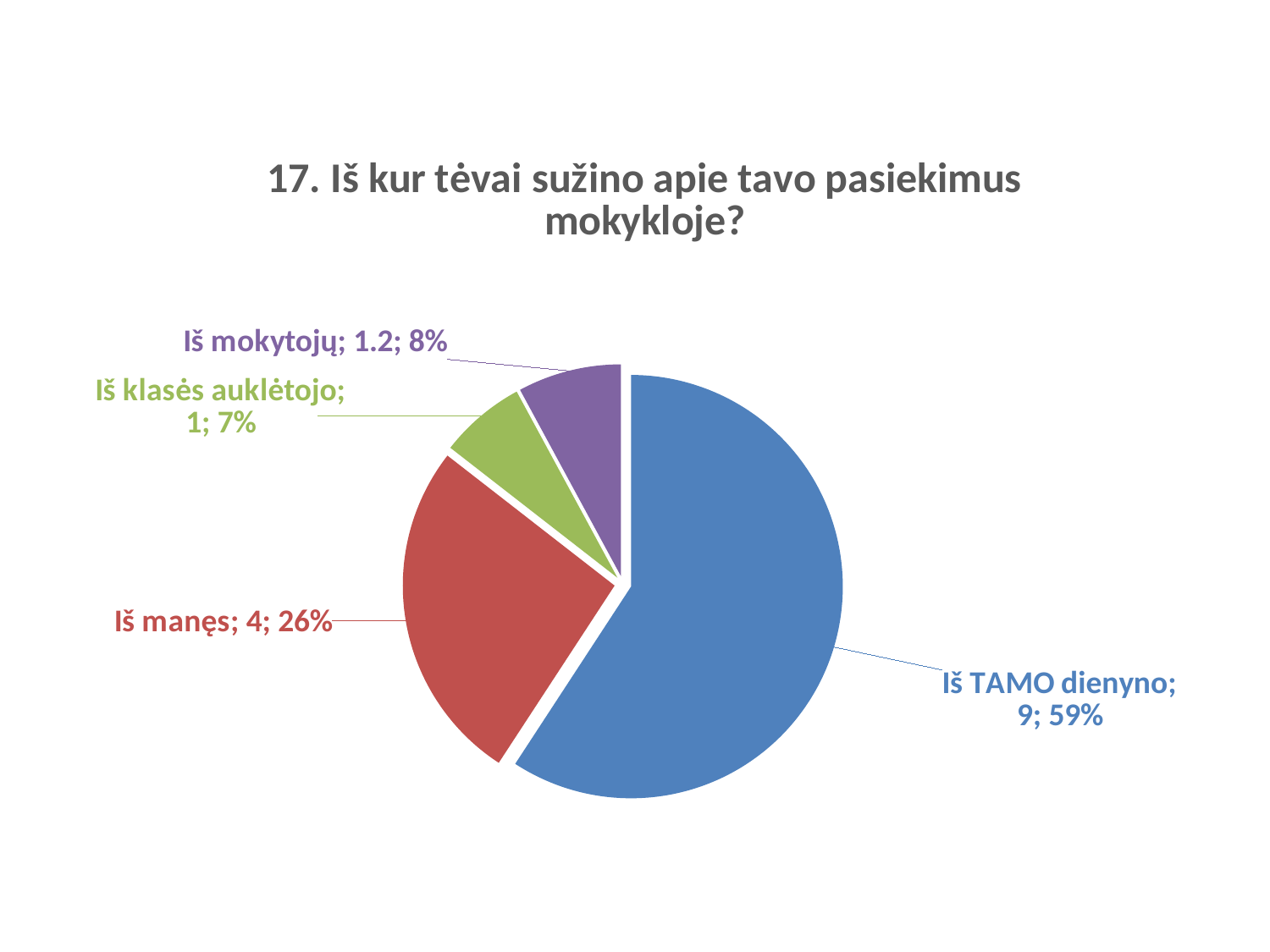
What value is shown for "Iš mokytojų"? 1.2 Which category has the smallest slice? Iš klasės auklėtojo What kind of chart is shown on the slide? pie chart What value is shown for "Iš manęs"? 4 What share of the pie does "Iš klasės auklėtojo" represent? 7% How many slices does the pie chart have? 4 What share of the pie does "Iš manęs" represent? 26% What is the difference between the values for "Iš TAMO dienyno" and "Iš manęs"? 5 What is the title of the chart? 17. Iš kur tėvai sužino apie tavo pasiekimus mokykloje? What share of the pie does "Iš TAMO dienyno" represent? 59% Which category has the largest slice? Iš TAMO dienyno What value is shown for "Iš TAMO dienyno"? 9